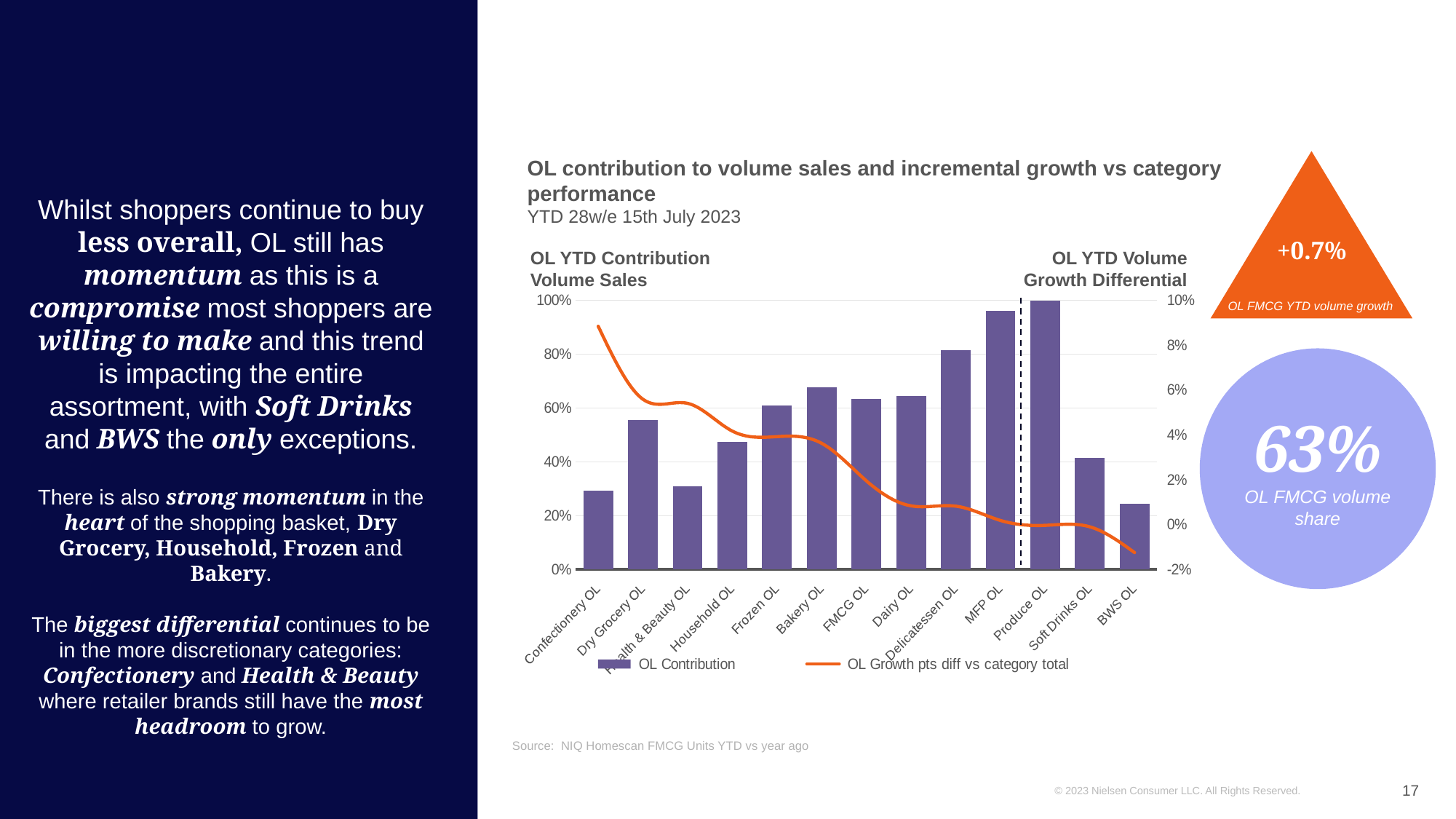
How many series does the chart legend list? 2 Which has the larger OL Contribution, MFP OL or Soft Drinks OL? MFP OL Is the OL Growth pts diff vs category total for BWS OL greater or less than 0%? less Is the OL Contribution for MFP OL greater or less than 80%? greater What is the title of the chart? OL contribution to volume sales and incremental growth vs category performance What kind of chart is used to show OL Contribution? bar chart Does the OL Growth pts diff vs category total line generally rise or fall from Confectionery OL to BWS OL? fall Is the OL Contribution for Dry Grocery OL greater or less than 40%? greater How many categories are shown on the x axis of the chart? 13 Which has the larger OL Contribution, Dry Grocery OL or Household OL? Dry Grocery OL Which category has the highest OL Contribution bar? Produce OL